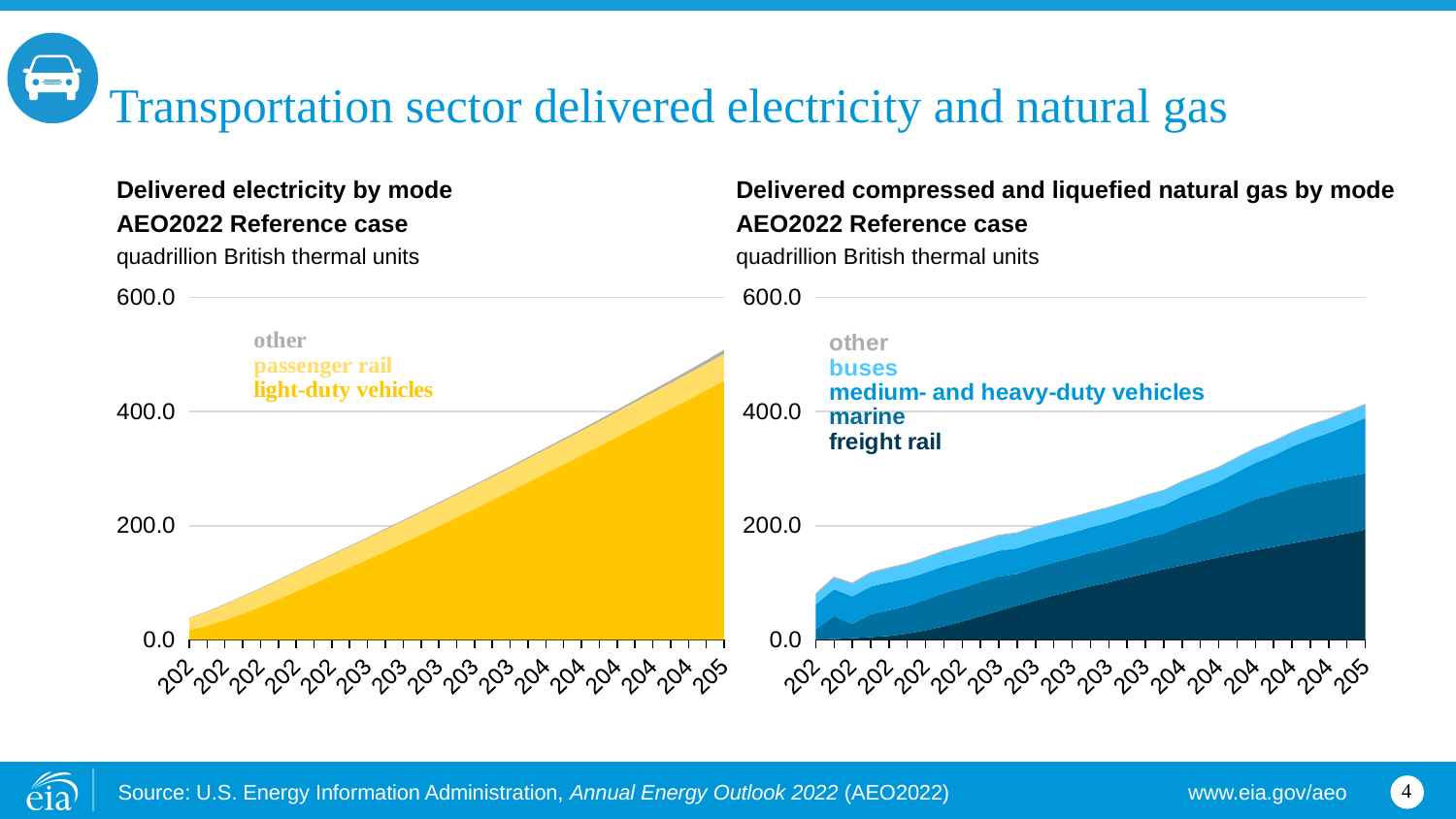
In the 'Delivered electricity by mode' chart, is the total value at the end of the projection period greater or less than 400.0? greater What is the highest value shown on the y axis of the 'Delivered electricity by mode' chart? 600.0 In the 'Delivered electricity by mode' chart, which mode accounts for the largest share of delivered electricity? light-duty vehicles In the 'Delivered electricity by mode' chart, do the total values rise or fall over time along the x axis? Rise In the 'Delivered compressed and liquefied natural gas by mode' chart, do the total values generally rise or fall over time along the x axis? Rise How many series does the legend of the 'Delivered compressed and liquefied natural gas by mode' chart list? 5 In the 'Delivered compressed and liquefied natural gas by mode' chart, is the total value at the start of the projection period greater or less than 200.0? less What type of chart is the 'Delivered electricity by mode' chart on the left? Stacked area chart In the 'Delivered electricity by mode' chart, is the total value at the start of the projection period greater or less than 200.0? less How many series does the legend of the 'Delivered electricity by mode' chart list? 3 What unit is used on the y axis of both charts? quadrillion British thermal units